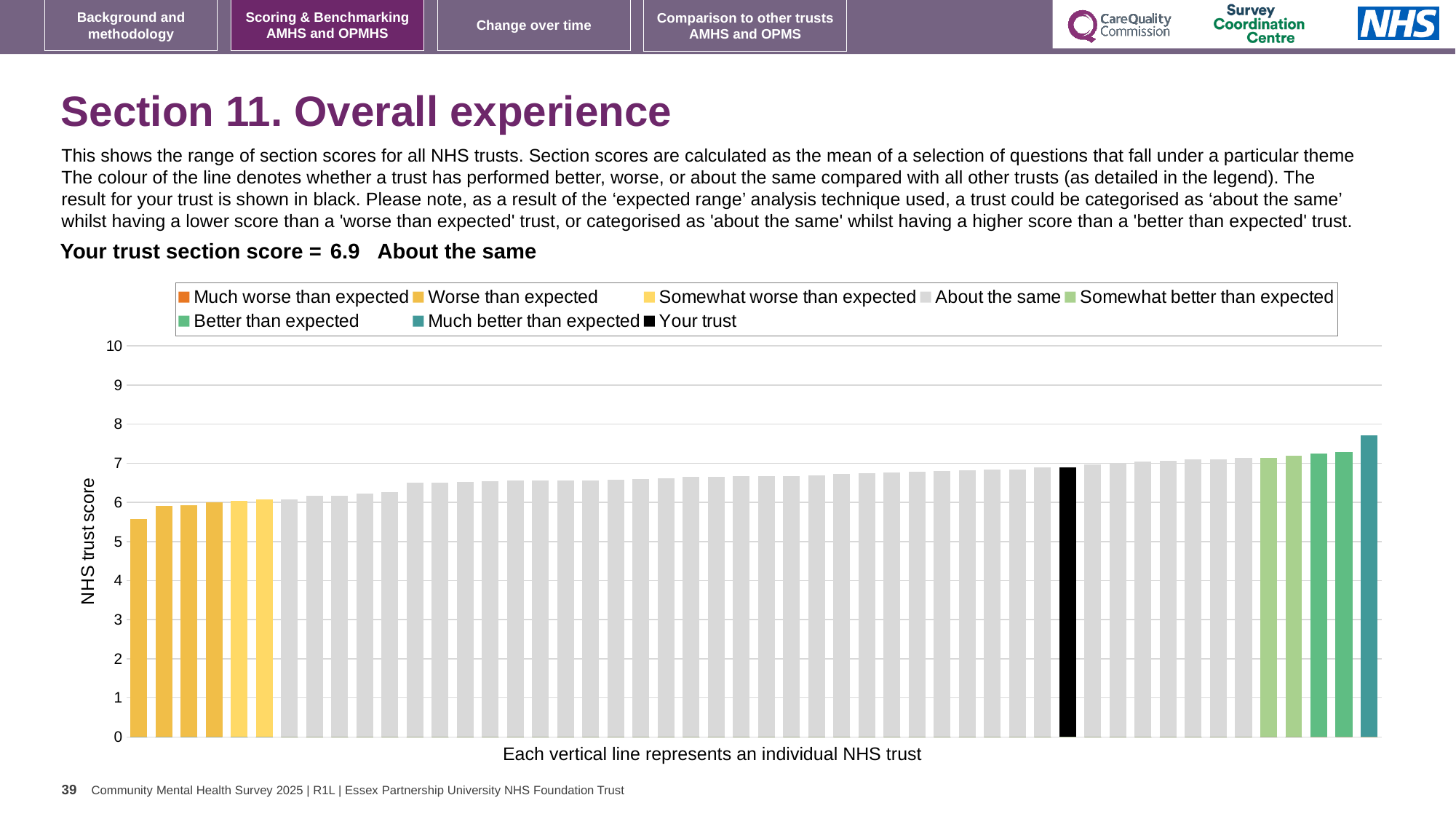
Is the value for your trust (the black bar) greater or less than 6? greater Do the bar values rise or fall from left to right along the x axis? Rise Is the value of the highest bar greater or less than 8? less Is the value of the lowest bar greater or less than 6? less What is the label on the y axis of the chart? NHS trust score How many entries does the chart legend list? 8 Which legend category does the highest bar belong to? Much better than expected What is the section score for your trust shown on the slide? 6.9 Which legend category does the lowest bar belong to? Worse than expected What kind of chart is shown on the slide? Bar chart What colour is the bar representing your trust? Black